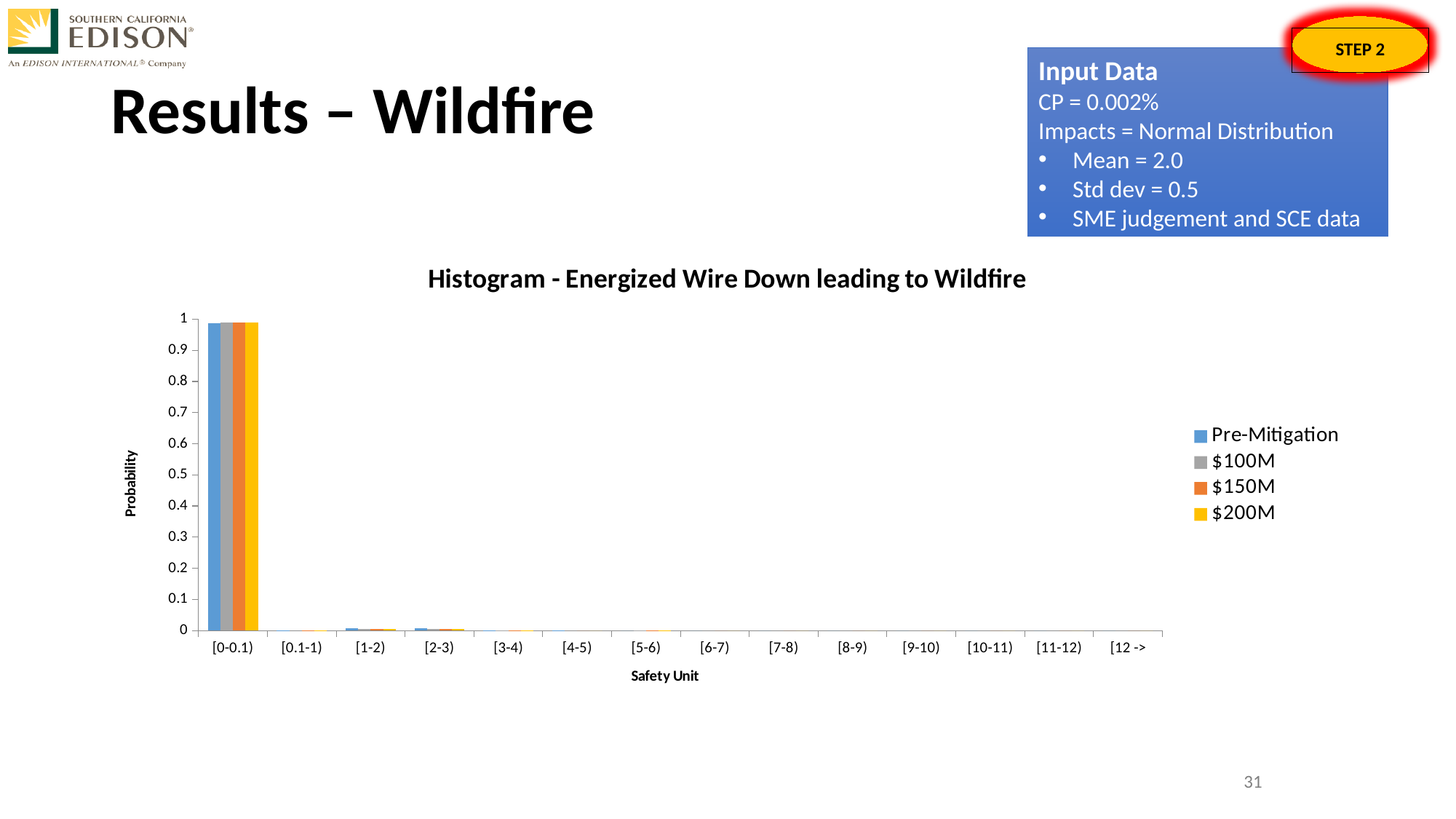
What is the title of the chart? Histogram - Energized Wire Down leading to Wildfire Which series is shown in yellow in the legend? $200M How many series does the legend list? 4 Which category has the highest probability for the Pre-Mitigation series? [0-0.1) Is the $200M value for [1-2] greater or less than 0.1? less Is the $100M value for [2-3] greater or less than 0.1? less What kind of chart is shown on the slide? bar chart How many categories are shown on the x axis? 14 Do the Pre-Mitigation values generally rise or fall moving from [0-0.1] to [12 ->] along the x axis? fall Which is larger for the $150M series: the value for [0-0.1] or the value for [1-2]? [0-0.1) Is the Pre-Mitigation value for [0-0.1] greater or less than 0.9? greater What is the label of the y axis? Probability